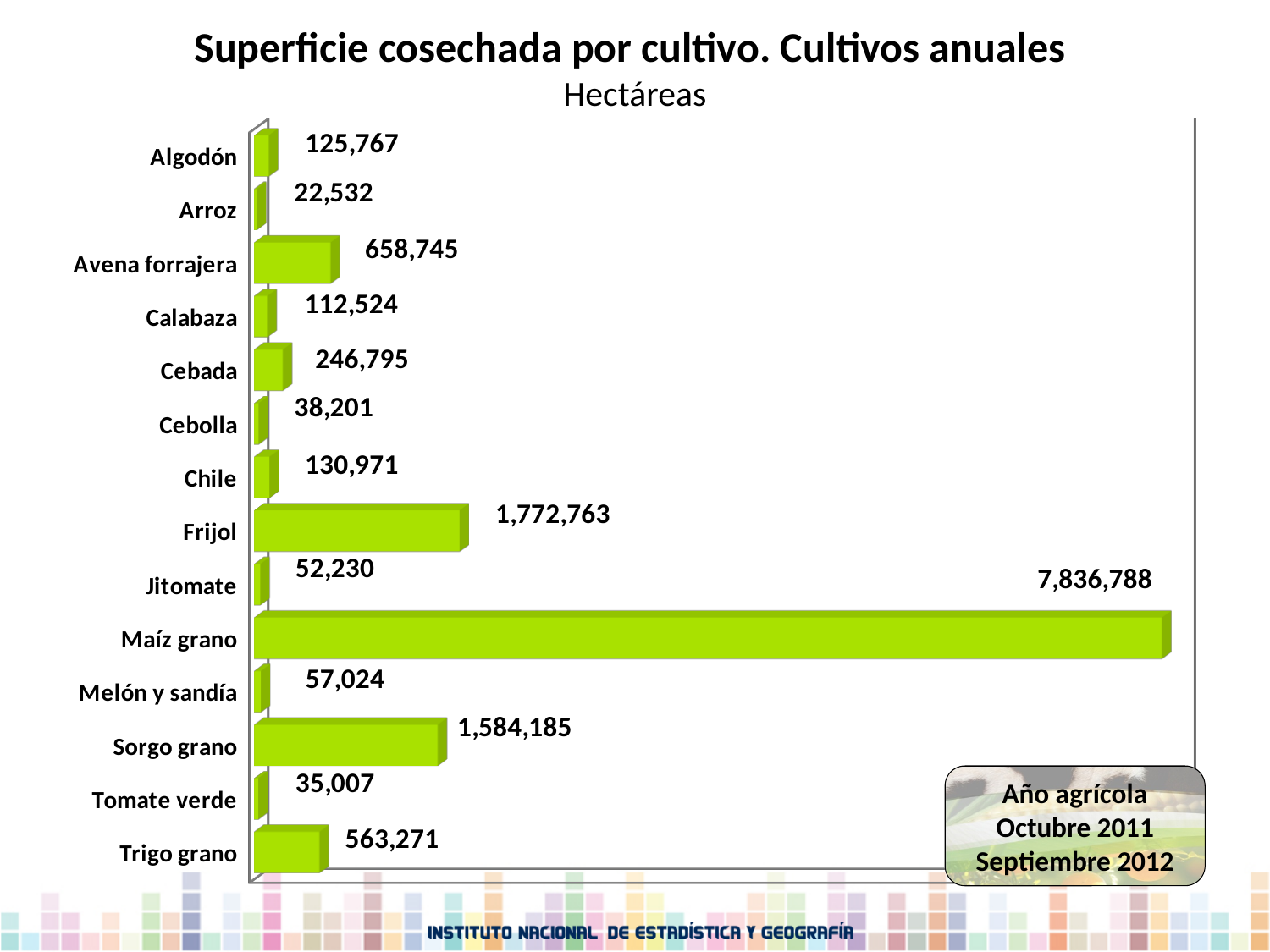
What unit is given in the chart subtitle? Hectáreas Which crop has the smallest harvested area? Arroz What is the harvested area for Tomate verde? 35,007 What is the difference in harvested area between Frijol and Sorgo grano? 188,578 What is the difference in harvested area between Avena forrajera and Trigo grano? 95,474 What is the harvested area for Frijol? 1,772,763 Which has a larger harvested area, Cebada or Chile? Cebada What is the harvested area for Maíz grano? 7,836,788 Which crop has the largest harvested area? Maíz grano What is the harvested area for Avena forrajera? 658,745 How many crops are shown in the chart? 14 What kind of chart is shown on the slide? Bar chart